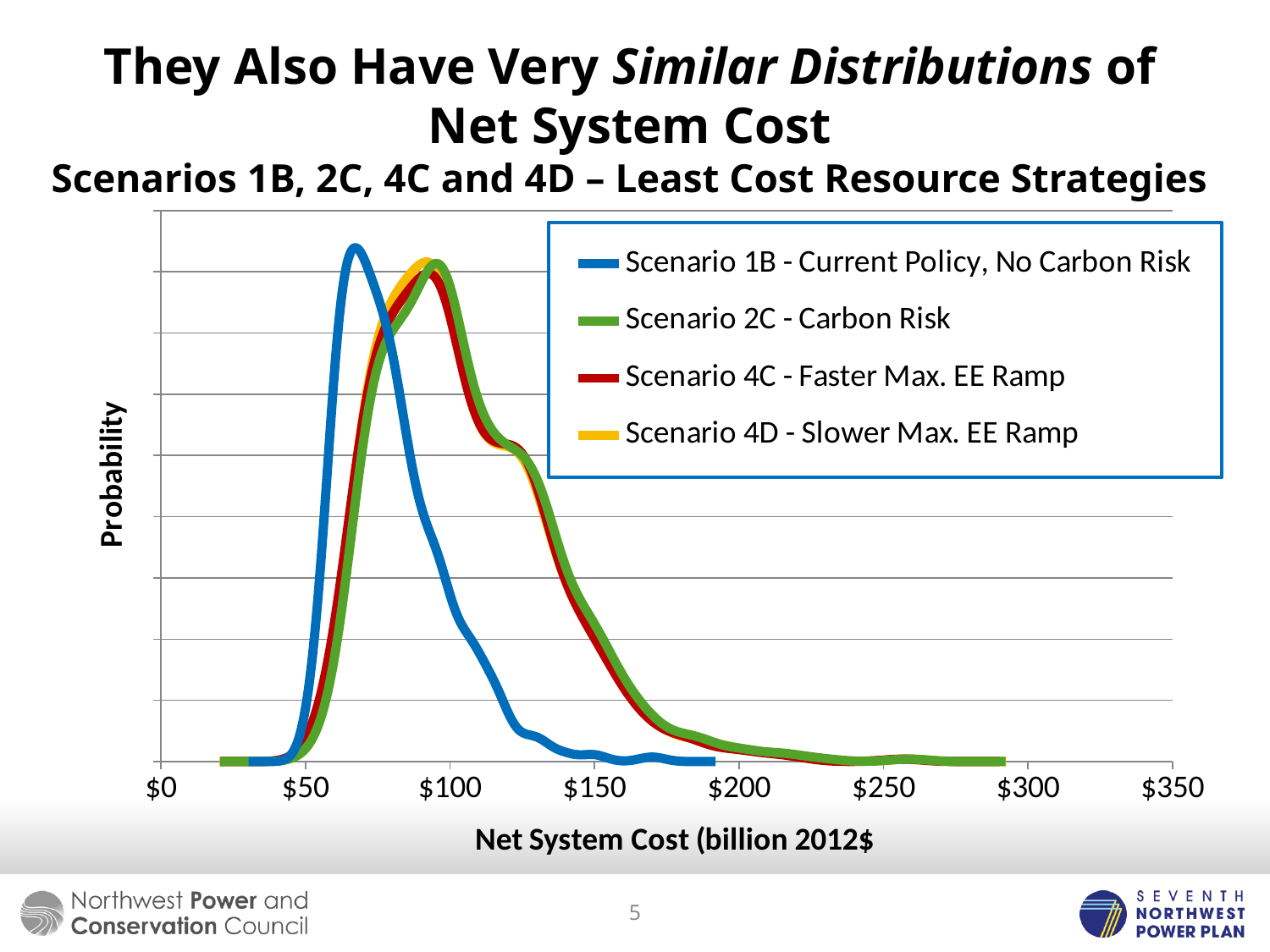
Is the net system cost at which the Scenario 1B curve drops to zero greater or less than $250? less What is the highest value labelled on the x axis? $350 What is the title of the y axis? Probability Is the net system cost at which the Scenario 2C curve peaks greater or less than $50? greater Is the net system cost at which the Scenario 1B curve peaks greater or less than $100? less Do the probability curves rise or fall as net system cost increases from $100 to $200? fall What is the title of the x axis? Net System Cost (billion 2012$ How many labelled tick marks are on the x axis? 8 What kind of chart is shown on the slide? Line chart Which scenario's curve reaches the highest peak probability? Scenario 1B - Current Policy, No Carbon Risk Which peaks at a lower net system cost, the Scenario 1B curve or the Scenario 4C curve? Scenario 1B How many series does the legend list? 4